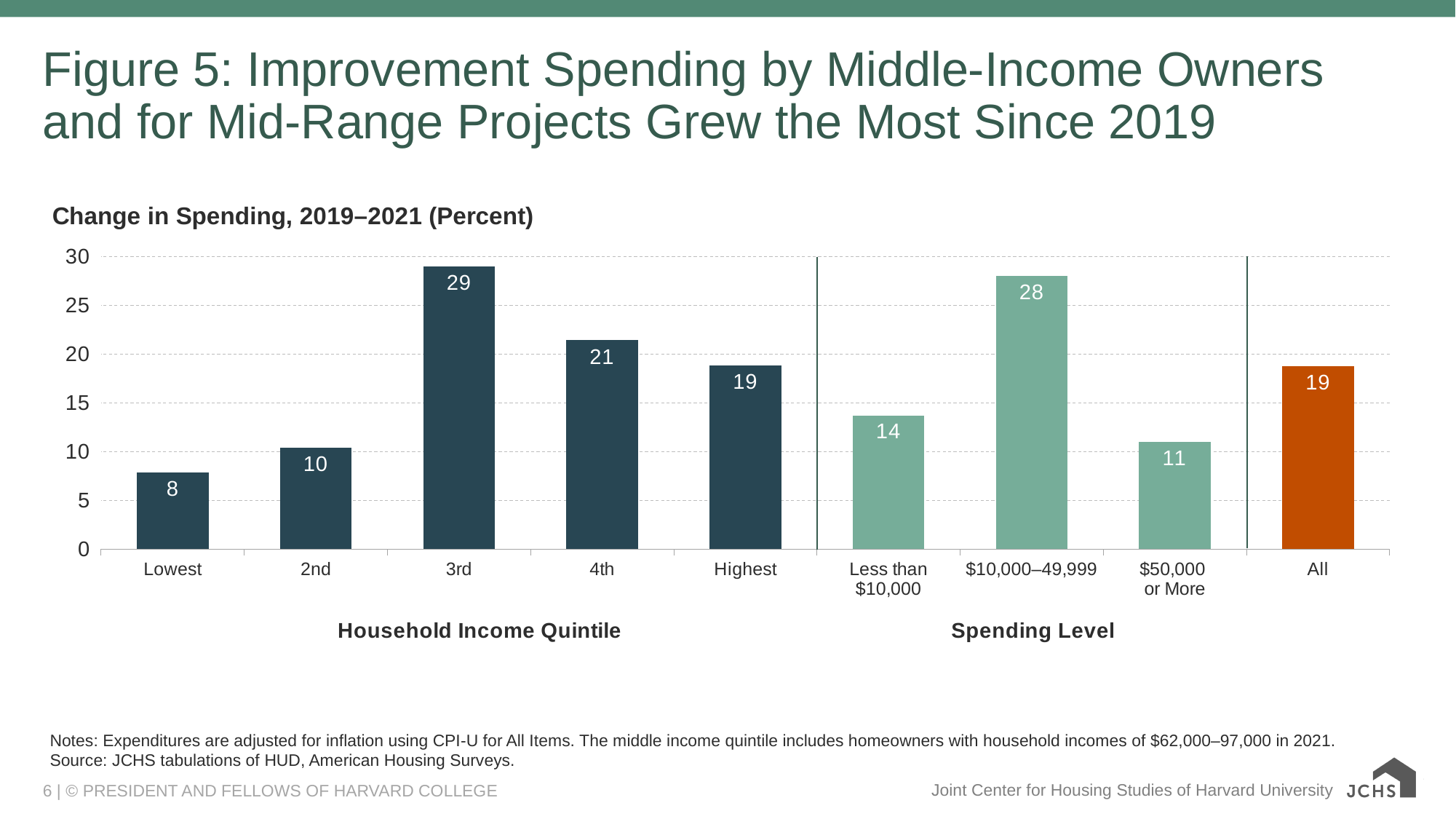
What is the change in spending for the $10,000–49,999 spending level? 28 Which category has the highest change in spending? 3rd What type of chart is shown on the slide? Bar chart What is the change in spending for the Lowest household income quintile? 8 Which category has the lowest change in spending? Lowest What is the change in spending for the All category? 19 Is the value for Less than $10,000 greater or less than 10? greater What is the difference between the change in spending for the 3rd quintile and the Lowest quintile? 21 Which has a larger change in spending, the 4th quintile or the Highest quintile? 4th What is the difference between the change in spending for the $10,000–49,999 spending level and the $50,000 or More spending level? 17 What is the change in spending for the 3rd household income quintile? 29 How many bars are shown in the chart? 9